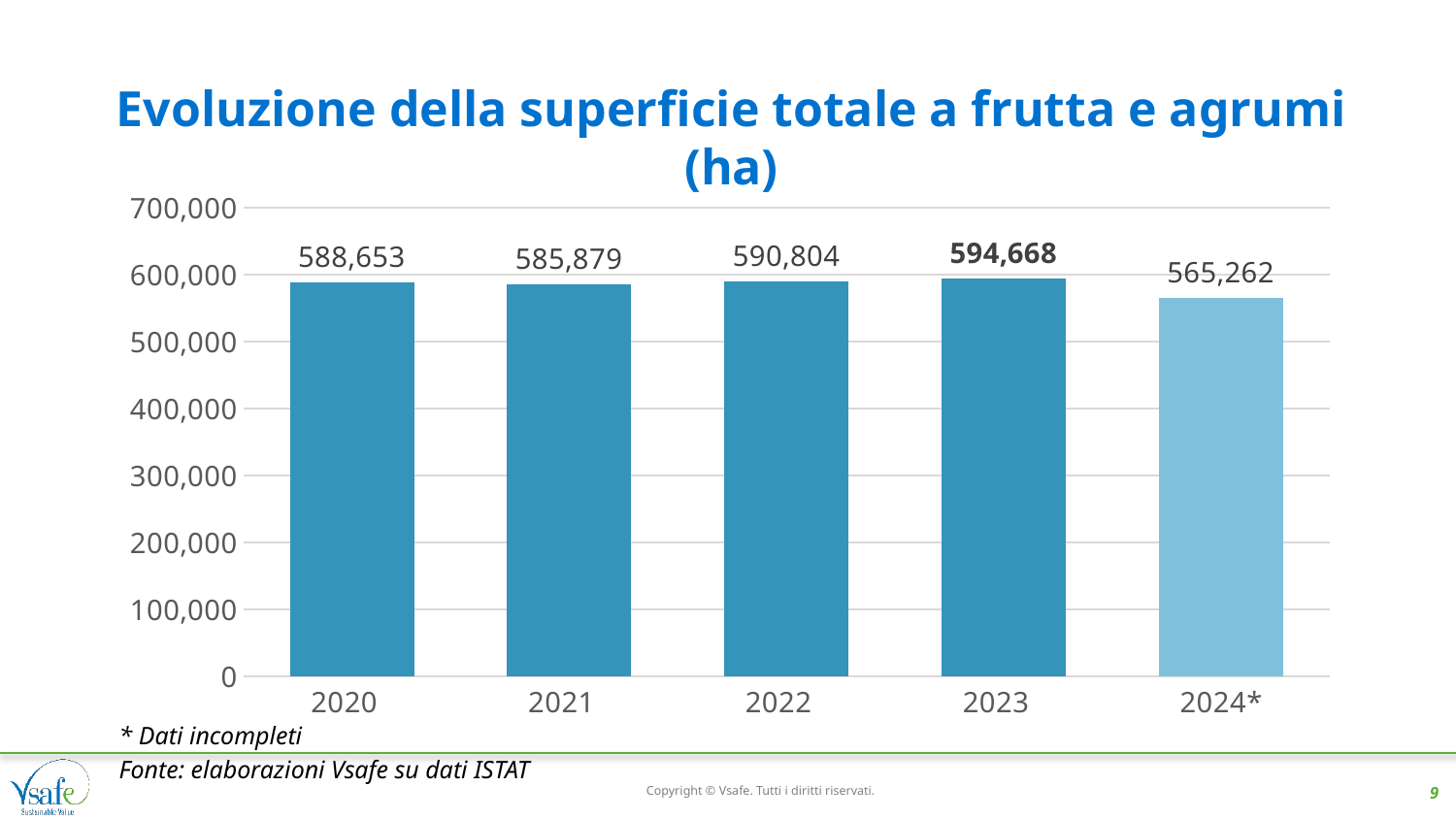
What kind of chart is this? bar chart Which year has the lowest value? 2024* How many years are shown on the x axis? 5 What is the title of the chart? Evoluzione della superficie totale a frutta e agrumi (ha) What is the difference between the values for 2022 and 2021? 4,925 What is the value for 2023? 594,668 Is the value for 2024* greater or less than 600,000? less Which is larger, the value for 2020 or the value for 2021? 2020 Which year has the highest value? 2023 What is the difference between the values for 2023 and 2024*? 29,406 What is the value for 2020? 588,653 What is the value for 2024*? 565,262